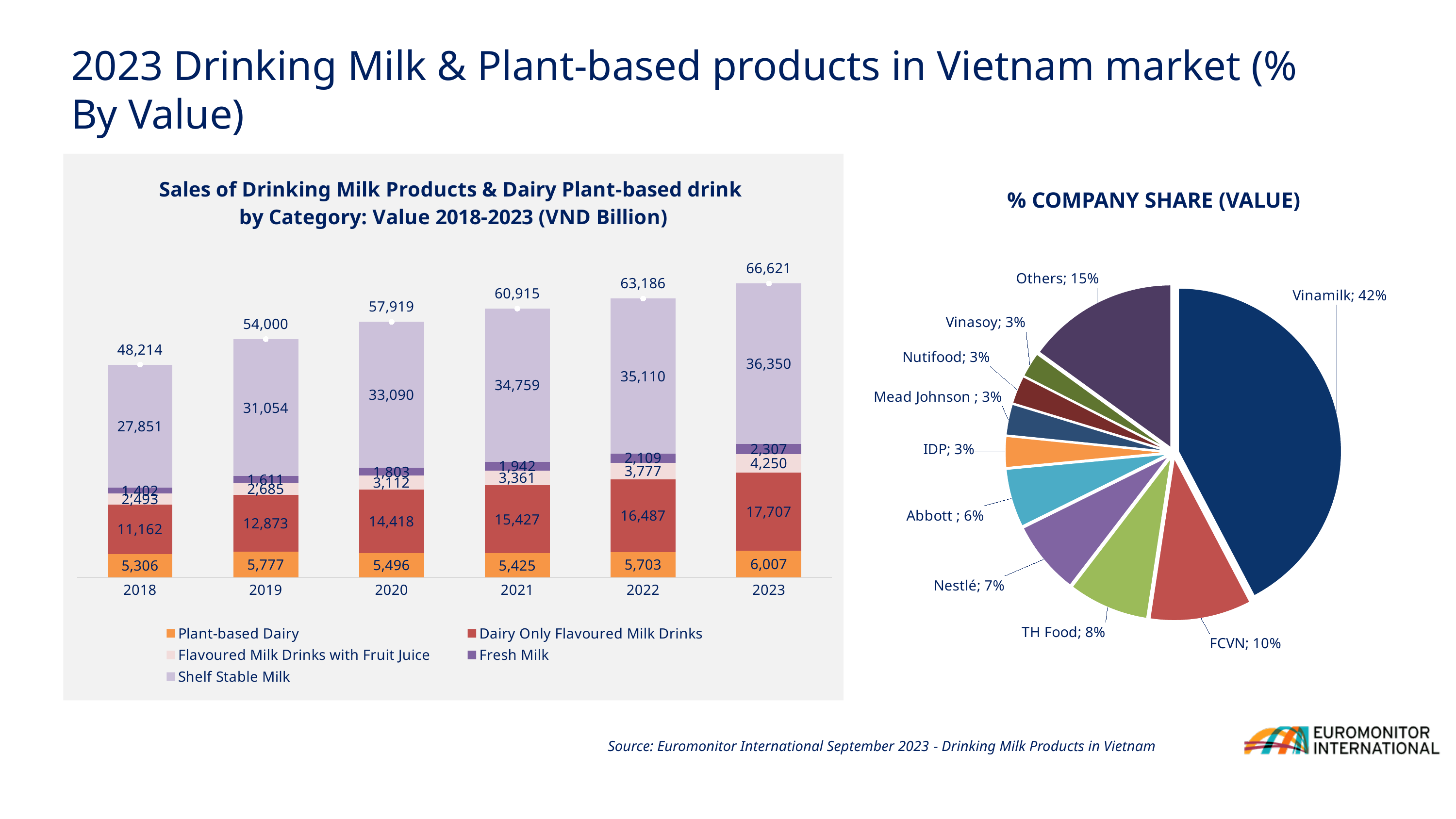
In the 'Sales of Drinking Milk Products & Dairy Plant-based drink by Category' chart, what is the difference between the Dairy Only Flavoured Milk Drinks values for 2023 and 2018? 6,545 In the '% COMPANY SHARE (VALUE)' pie chart, what share does FCVN have? 10% In the 'Sales of Drinking Milk Products & Dairy Plant-based drink by Category' chart, is the Fresh Milk value larger in 2021 or in 2022? 2022 How many slices does the '% COMPANY SHARE (VALUE)' pie chart have? 10 In the 'Sales of Drinking Milk Products & Dairy Plant-based drink by Category' chart, what is the Plant-based Dairy value for 2019? 5,777 In the '% COMPANY SHARE (VALUE)' pie chart, which company has the largest share? Vinamilk In the 'Sales of Drinking Milk Products & Dairy Plant-based drink by Category' chart, what is the total value for 2023? 66,621 What kind of chart is the 'Sales of Drinking Milk Products & Dairy Plant-based drink by Category' chart? stacked bar chart In the 'Sales of Drinking Milk Products & Dairy Plant-based drink by Category' chart, do the total values rise or fall from 2018 to 2023? rise In the 'Sales of Drinking Milk Products & Dairy Plant-based drink by Category' chart, what is the Shelf Stable Milk value for 2020? 33,090 In the 'Sales of Drinking Milk Products & Dairy Plant-based drink by Category' chart, which year has the lowest total value? 2018 In the 'Sales of Drinking Milk Products & Dairy Plant-based drink by Category' chart, how many series does the legend list? 5